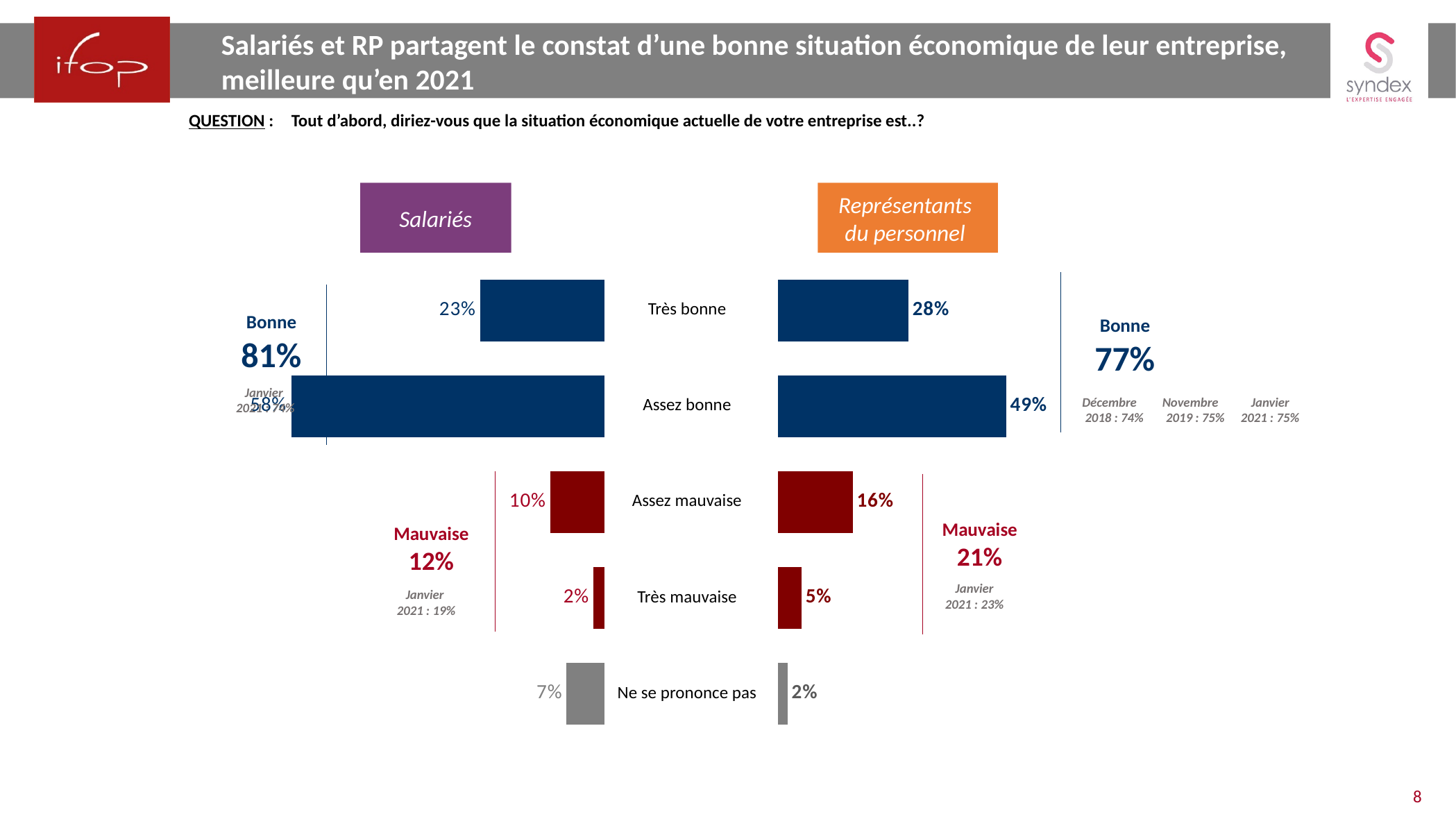
What is the difference between the "Assez bonne" values in the Salariés chart and the Représentants du personnel chart? 9 percentage points In the Salariés chart, which category has the highest value? Assez bonne In the Salariés chart, what is the combined "Bonne" total shown for "Très bonne" and "Assez bonne"? 81% In the Représentants du personnel chart, which category has the lowest value? Ne se prononce pas In the Représentants du personnel chart, what is the combined "Mauvaise" total shown for "Assez mauvaise" and "Très mauvaise"? 21% How many response categories are shown in the Salariés chart? 5 Which is larger: "Assez mauvaise" for Salariés or "Assez mauvaise" for Représentants du personnel? Représentants du personnel What kind of chart is used to show the Salariés results? Bar chart In the Représentants du personnel chart, what is the value for "Très mauvaise"? 5% In the Représentants du personnel chart, what is the value for "Assez bonne"? 49% In the Salariés chart, what is the value for "Ne se prononce pas"? 7% In the Salariés chart, what is the value for "Très bonne"? 23%